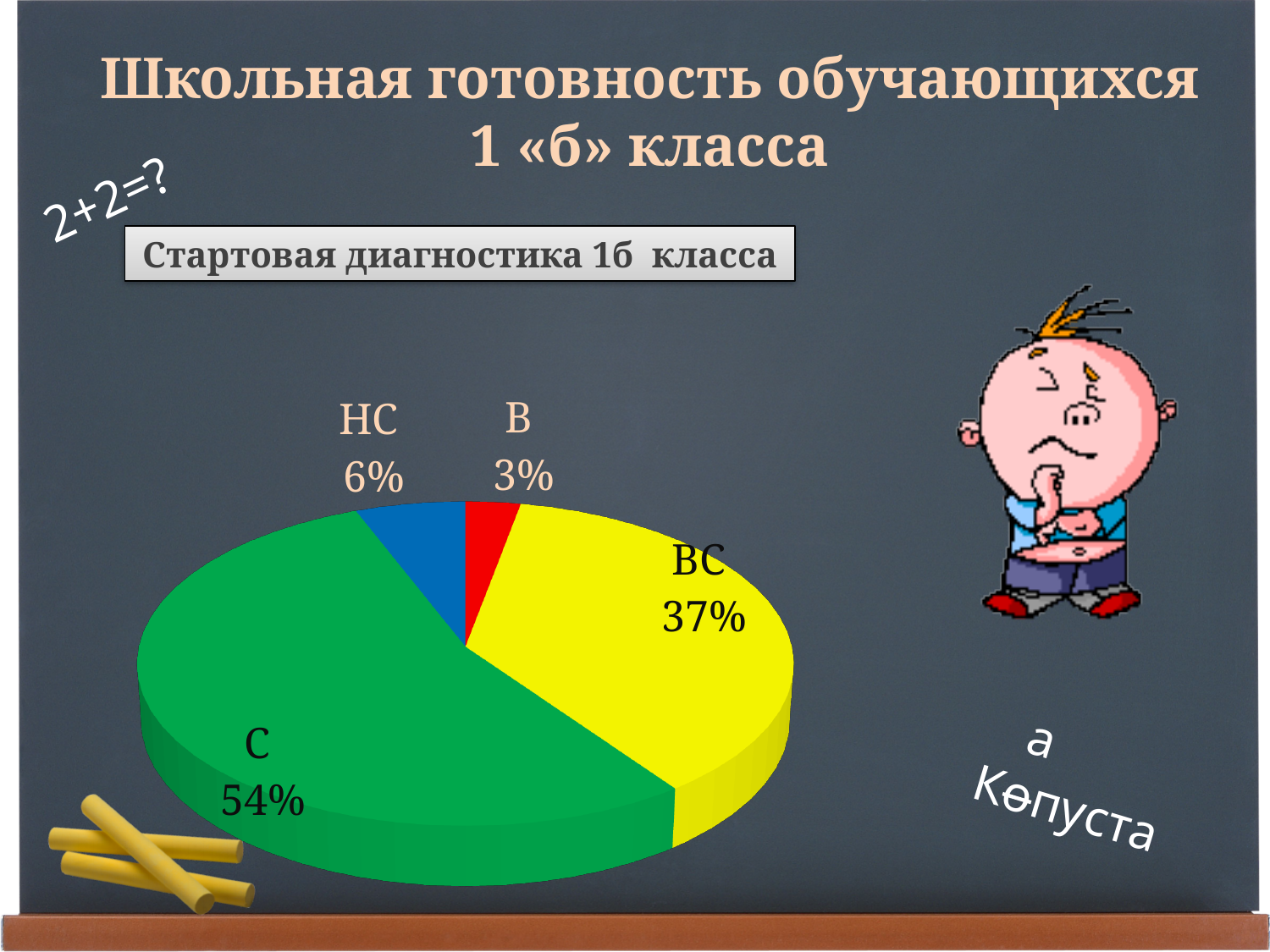
What percentage does the ВС slice represent? 37% How many slices does the pie chart have? 4 What percentage does the В slice represent? 3% What kind of chart is shown on the slide? pie chart What colour is the С slice? green Which category has the smallest share of the pie? В Which category has the largest share of the pie? С What percentage does the НС slice represent? 6% What is the difference in percentage points between the С and ВС slices? 17 Which is larger, the НС slice or the В slice? НС What is the title shown in the box above the chart? Стартовая диагностика 1б класса What percentage does the С slice represent? 54%